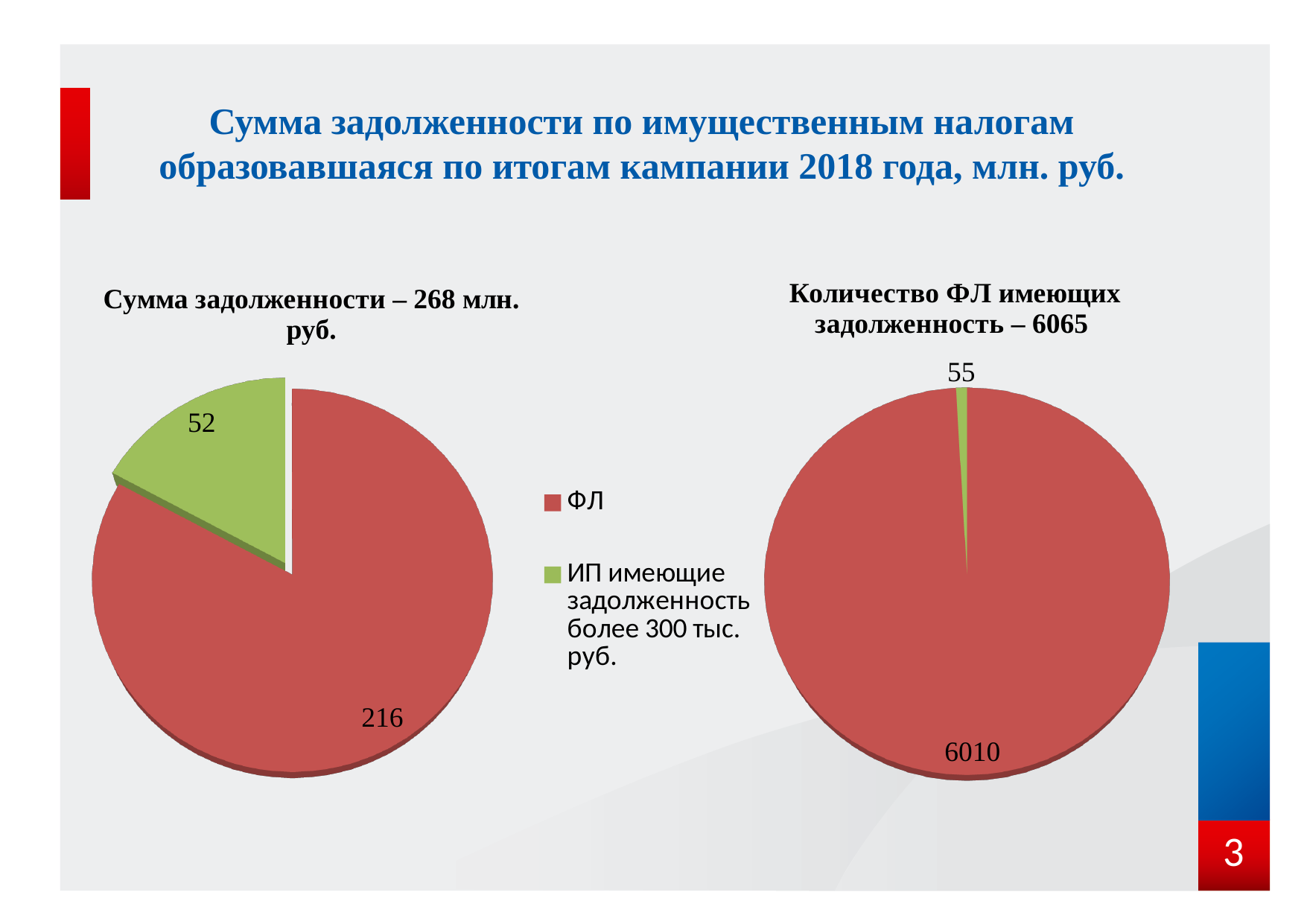
In the right chart "Количество ФЛ имеющих задолженность – 6065", which category has the smallest slice? ИП имеющие задолженность более 300 тыс. руб. How many slices does the left chart "Сумма задолженности – 268 млн. руб." have? 2 In the right chart "Количество ФЛ имеющих задолженность – 6065", what is the value for ИП имеющие задолженность более 300 тыс. руб.? 55 In the right chart "Количество ФЛ имеющих задолженность – 6065", what is the difference between the ФЛ value and the ИП value? 5955 In the left chart "Сумма задолженности – 268 млн. руб.", what is the value for ФЛ? 216 In the right chart "Количество ФЛ имеющих задолженность – 6065", what is the value for ФЛ? 6010 How many entries does the legend between the two charts list? 2 In the left chart "Сумма задолженности – 268 млн. руб.", what is the value for ИП имеющие задолженность более 300 тыс. руб.? 52 What kind of chart is the left chart titled "Сумма задолженности – 268 млн. руб."? pie chart In the left chart "Сумма задолженности – 268 млн. руб.", what is the difference between the ФЛ value and the ИП value? 164 In the left chart "Сумма задолженности – 268 млн. руб.", which category has the largest slice? ФЛ What colour is the ФЛ slice in both pie charts? red